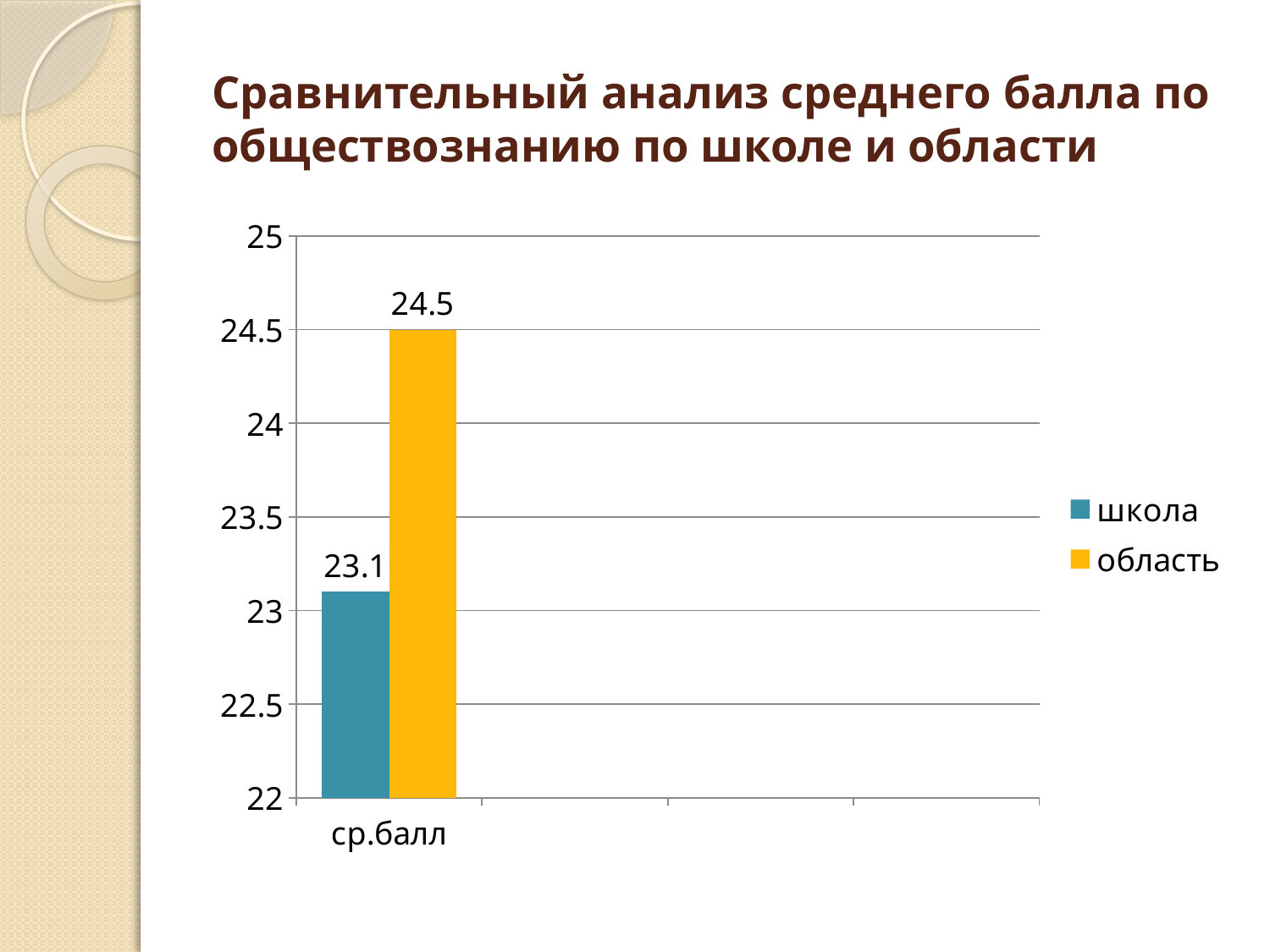
Is the value for школа greater or less than 23.5? less How many series does the legend list? 2 What is the category label on the x axis? ср.балл Which series has the highest value in the chart? область What is the value for школа in the chart? 23.1 Which series has the higher value, школа or область? область Which series has the lowest value in the chart? школа Is the value for область greater or less than 24? greater What colour is the bar for область? yellow What is the value for область in the chart? 24.5 What kind of chart is shown on the slide? bar chart What is the difference between the область value and the школа value? 1.4